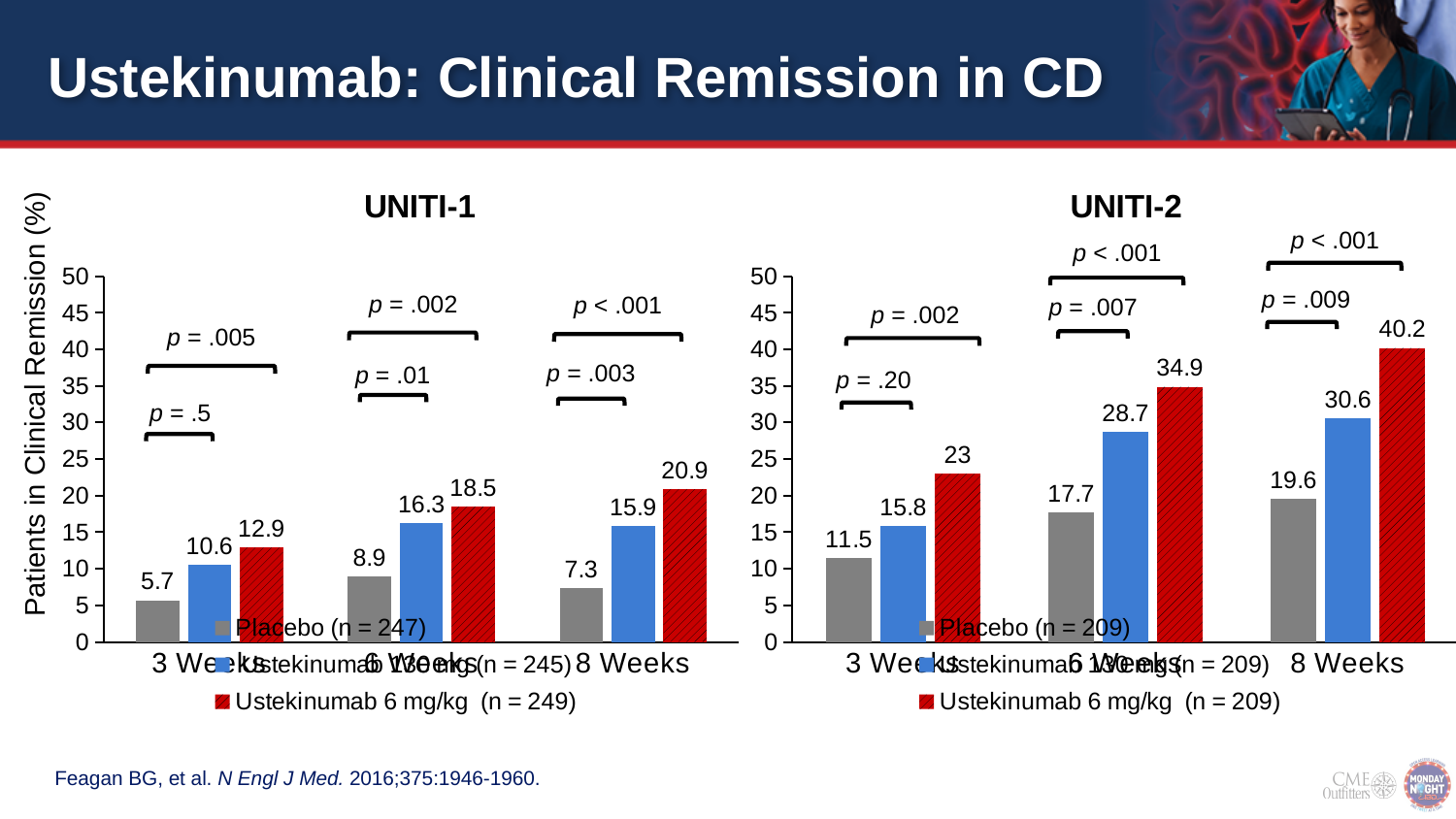
In the UNITI-1 chart, what is the value for Ustekinumab 6 mg/kg at 8 Weeks? 20.9 In the UNITI-2 chart, what is the value for Ustekinumab 130 mg at 6 Weeks? 28.7 In the UNITI-2 chart, what is the value for Placebo at 3 Weeks? 11.5 In the UNITI-1 chart, which bar has the lowest value overall? Placebo at 3 Weeks How many series does the legend of the UNITI-2 chart list? 3 In the UNITI-1 chart, which time point has the highest Placebo value? 6 Weeks What kind of chart is the UNITI-1 chart? Bar chart In the UNITI-1 chart, which is larger at 8 Weeks: Ustekinumab 130 mg or Ustekinumab 6 mg/kg? Ustekinumab 6 mg/kg In the UNITI-2 chart, what is the difference between Ustekinumab 6 mg/kg and Placebo at 8 Weeks? 20.6 In the UNITI-1 chart, what is the difference between Ustekinumab 130 mg and Placebo at 6 Weeks? 7.4 In the UNITI-2 chart, which bar has the highest value overall? Ustekinumab 6 mg/kg at 8 Weeks In the UNITI-2 chart, does the Ustekinumab 6 mg/kg value rise or fall from 3 Weeks to 8 Weeks? Rise